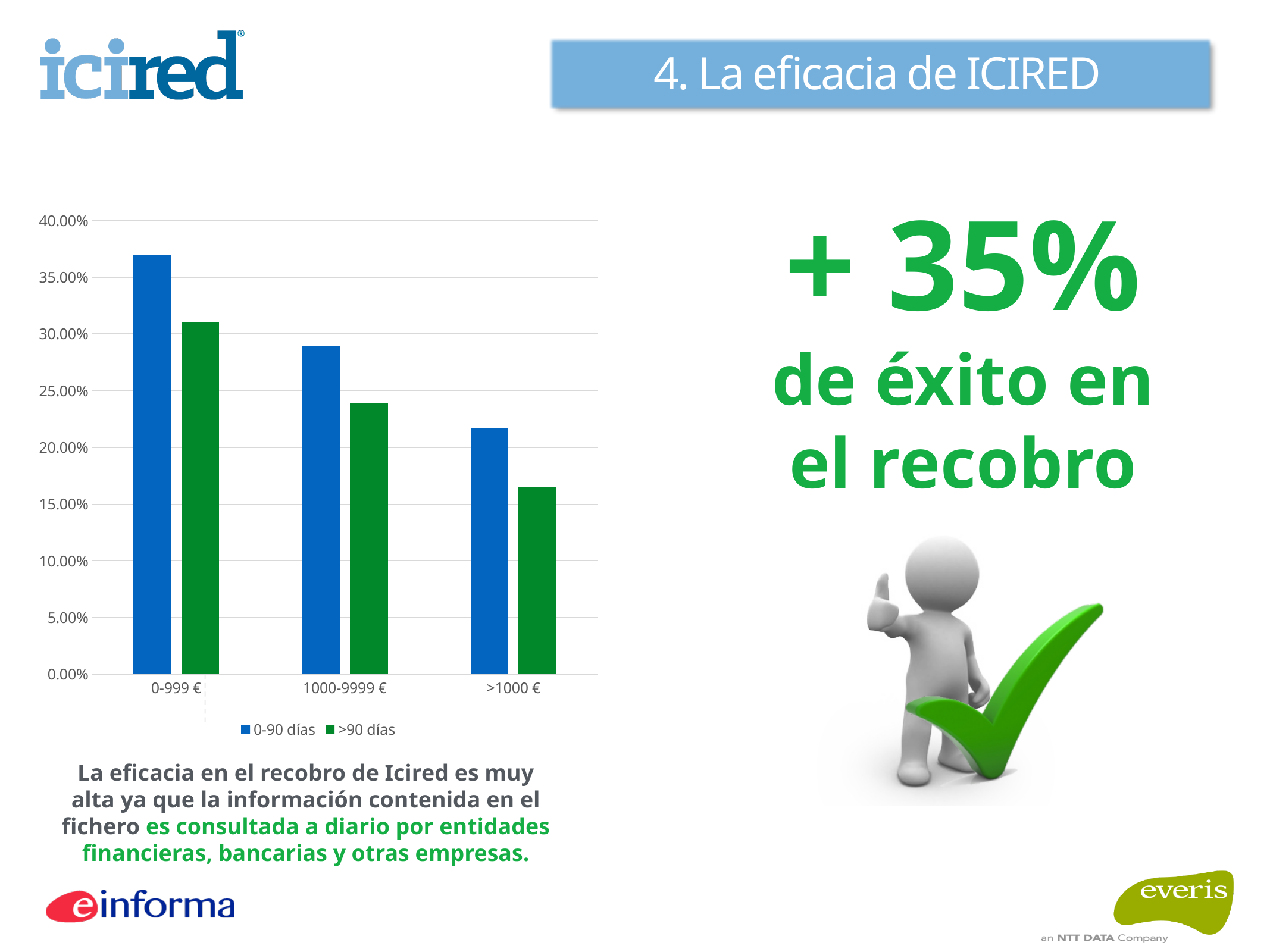
Do the values for the 0-90 días series rise or fall from left to right across the categories? fall Which category has the highest value for the 0-90 días series? 0-999 € Is the value for >90 días in the >1000 € category greater or less than 20.00%? less Is the value for >90 días in the 0-999 € category greater or less than 25.00%? greater Is the value for 0-90 días in the 0-999 € category greater or less than 35.00%? greater How many series does the chart legend list? 2 How many categories are shown on the x axis of the chart? 3 What kind of chart is shown on the slide? bar chart Which category has the lowest value for the >90 días series? >1000 € For the 1000-9999 € category, which series has the larger value, 0-90 días or >90 días? 0-90 días What colour are the bars for the >90 días series? green